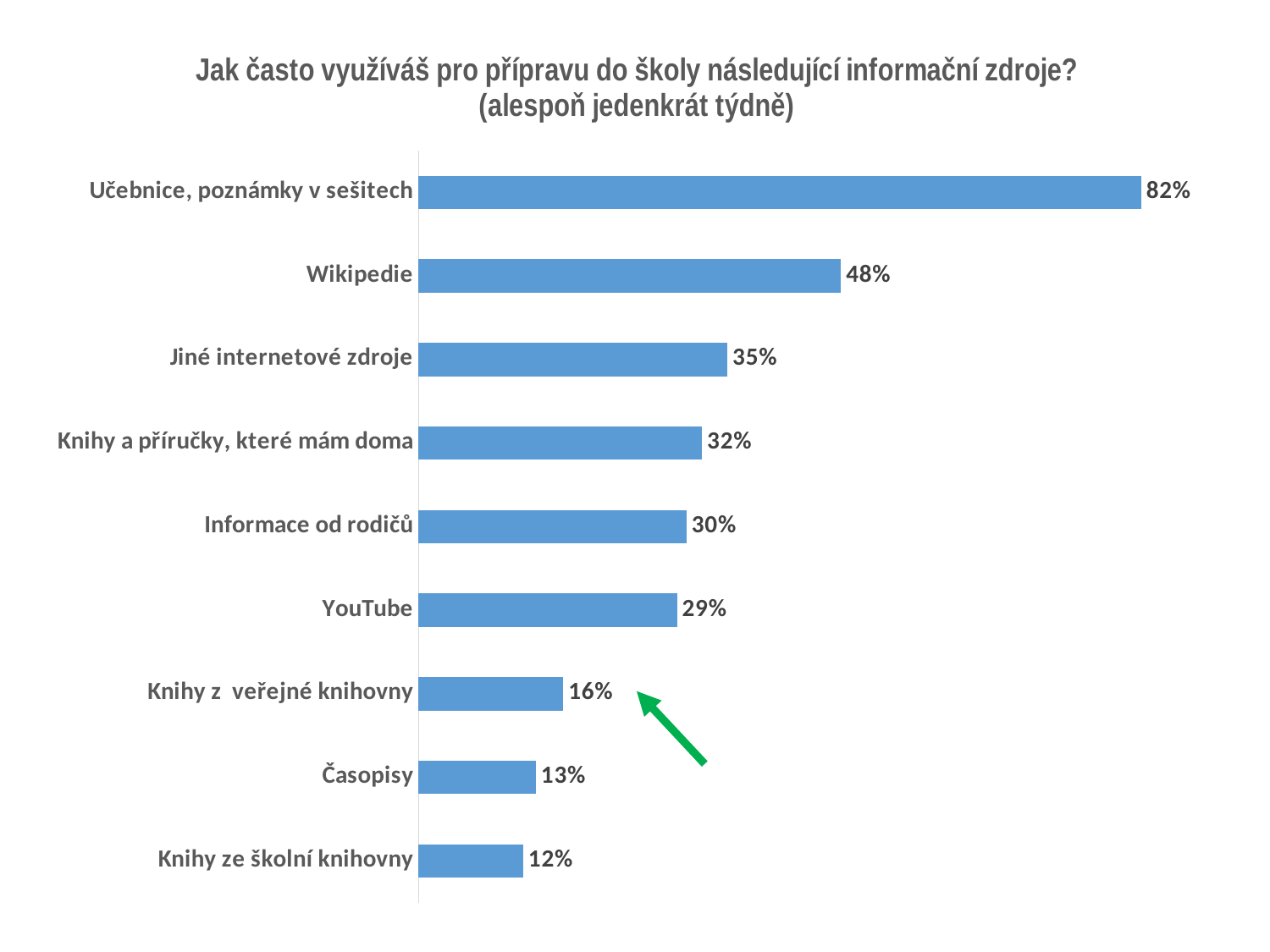
What is the value for Knihy z veřejné knihovny? 16% What is the value for Wikipedie? 48% What is the value for Knihy ze školní knihovny? 12% Which category has the lowest value? Knihy ze školní knihovny What is the value for YouTube? 29% What is the difference between the values for Jiné internetové zdroje and Časopisy? 22% What is the difference between the values for Učebnice, poznámky v sešitech and Wikipedie? 34% Which category does the green arrow point to? Knihy z veřejné knihovny What kind of chart is shown on the slide? Bar chart Which is larger, the value for Knihy a příručky, které mám doma or the value for Informace od rodičů? Knihy a příručky, které mám doma Which category has the highest value? Učebnice, poznámky v sešitech How many categories are shown in the chart? 9